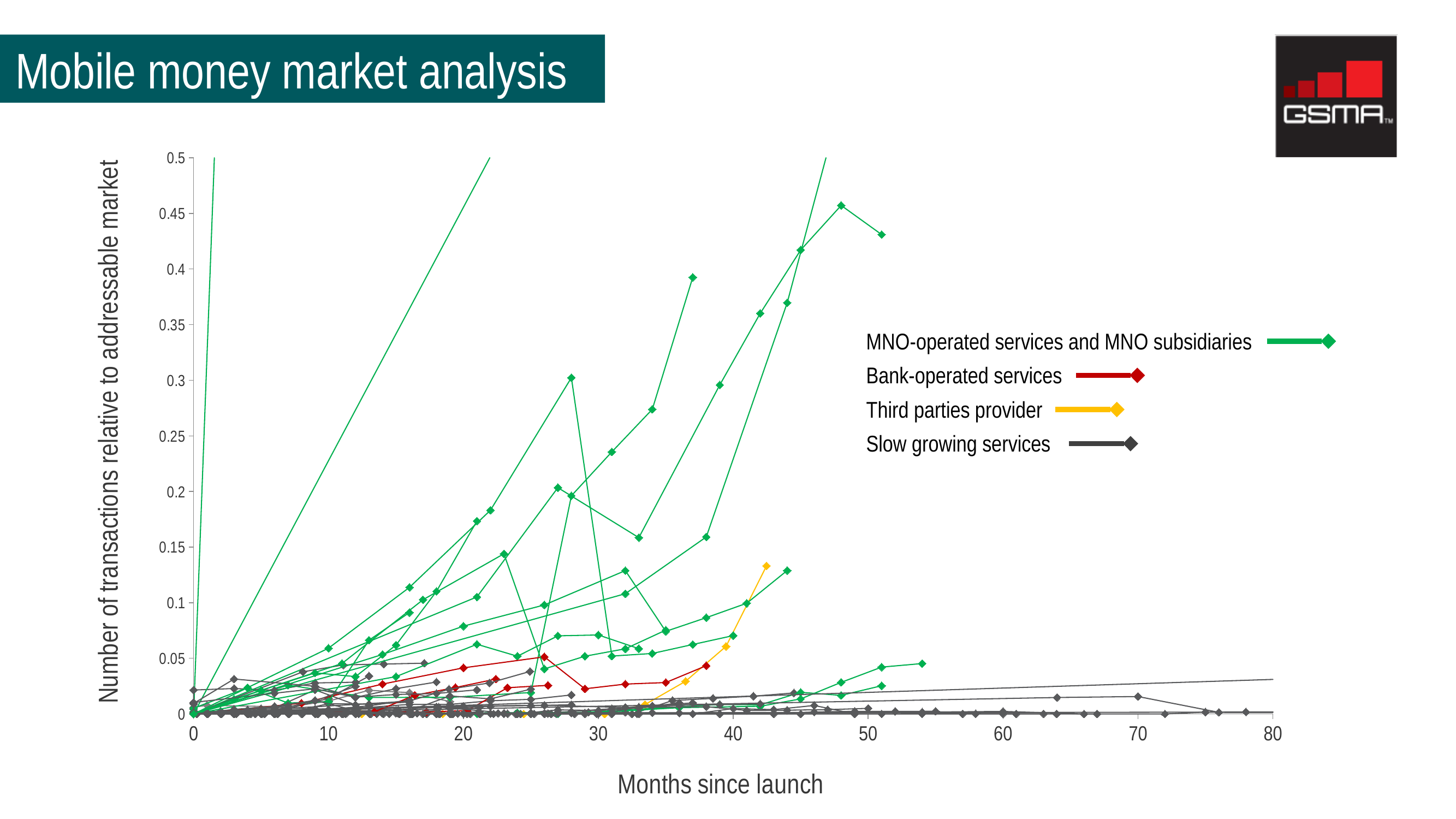
Is the highest value reached by the Third parties provider line greater or less than 0.1? greater Is the highest value reached by the Bank-operated services lines greater or less than 0.1? less What kind of chart is shown on the slide? Line chart What is the maximum value shown on the x axis? 80 What is the title of the slide containing the chart? Mobile money market analysis What is the label of the x axis? Months since launch Which reaches higher values: the Third parties provider line or the Bank-operated services lines? Third parties provider Is the highest marked point of the MNO-operated services lines greater or less than 0.4? greater How many series does the legend list? 4 Do the MNO-operated services lines generally rise or fall as months since launch increase? rise Which legend category reaches the highest values on the chart? MNO-operated services and MNO subsidiaries